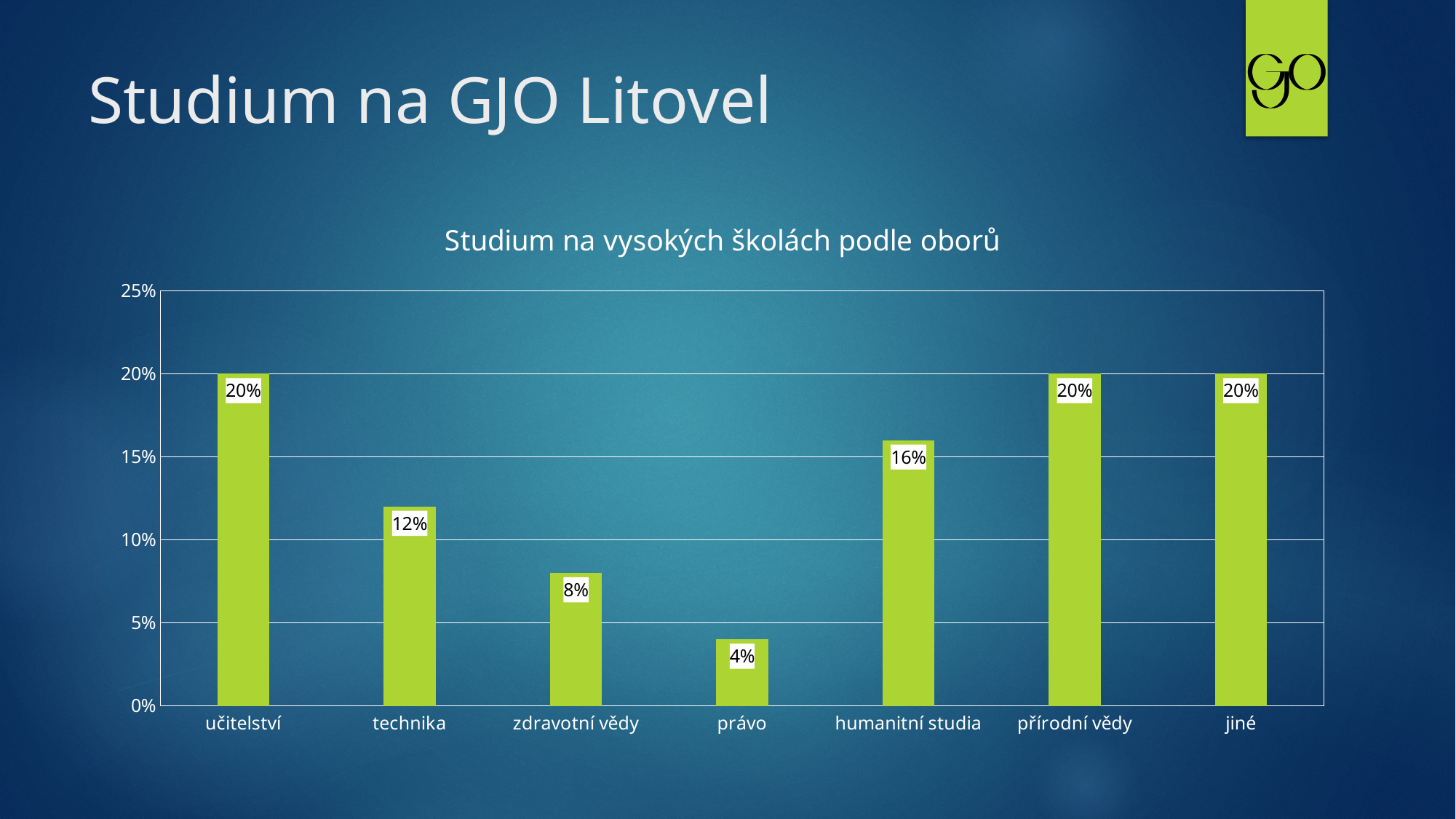
What is the value for právo? 4% What is the title of the chart? Studium na vysokých školách podle oborů What is the difference between the values for humanitní studia and právo? 12% How many categories are shown on the x axis? 7 What kind of chart is shown on the slide? bar chart Is the value for technika greater or less than 10%? greater Which is larger, the value for zdravotní vědy or the value for humanitní studia? humanitní studia Which category has the lowest value? právo What is the value for technika? 12% What is the difference between the values for učitelství and technika? 8% What is the value for humanitní studia? 16% What is the value for zdravotní vědy? 8%